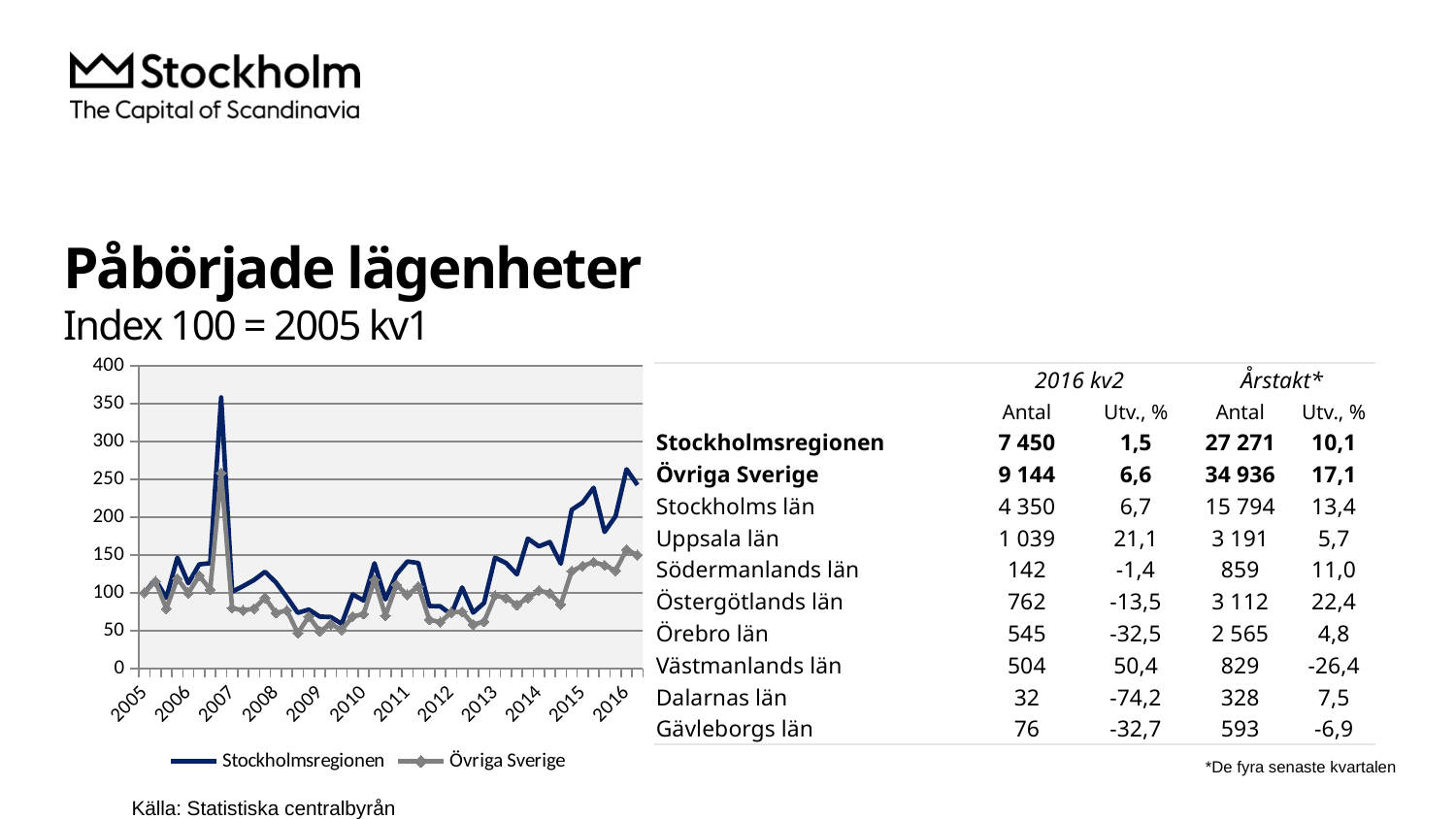
How many years are labelled on the x axis of the chart? 12 At the end of the series in 2016, which series is higher, Stockholmsregionen or Övriga Sverige? Stockholmsregionen What is the base period of the index shown in the chart (Index 100)? 2005 kv1 Is the value for Övriga Sverige at the end of the series in 2016 greater or less than 200? less Does the Stockholmsregionen series generally rise or fall from 2013 to 2016? rise What kind of chart is shown on the slide? line chart Is the peak value for Stockholmsregionen in 2007 greater or less than 300? greater Is the peak value for Övriga Sverige in 2007 greater or less than 200? greater How many series does the chart legend list? 2 Which two series are shown in the chart legend? Stockholmsregionen and Övriga Sverige Which series reaches the highest point on the chart? Stockholmsregionen